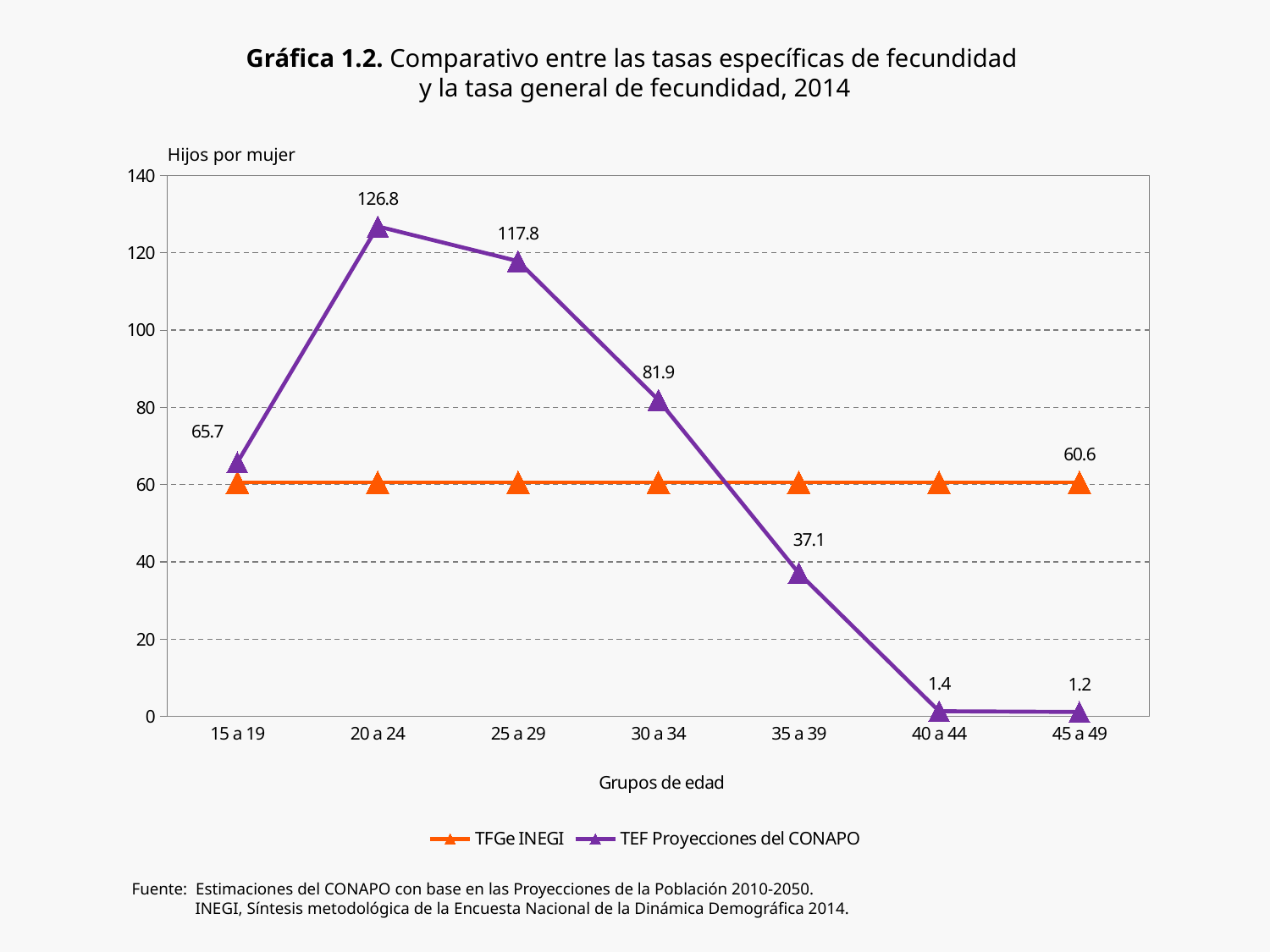
How many series does the legend list? 2 What is the TEF Proyecciones del CONAPO value for the 20 a 24 age group? 126.8 What value is labelled for the TFGe INEGI series at the 45 a 49 age group? 60.6 Which is larger for the 30 a 34 age group: the TEF Proyecciones del CONAPO value or the TFGe INEGI value? TEF Proyecciones del CONAPO What is the TEF Proyecciones del CONAPO value for the 35 a 39 age group? 37.1 What kind of chart is shown on the slide? Line chart What is the label of the y axis? Hijos por mujer Is the TEF Proyecciones del CONAPO value for 25 a 29 greater or less than 100? greater Which age group has the lowest TEF Proyecciones del CONAPO value? 45 a 49 How many age groups are shown on the x axis? 7 What is the difference between the TEF Proyecciones del CONAPO values for 20 a 24 and 25 a 29? 9.0 Which age group has the highest TEF Proyecciones del CONAPO value? 20 a 24